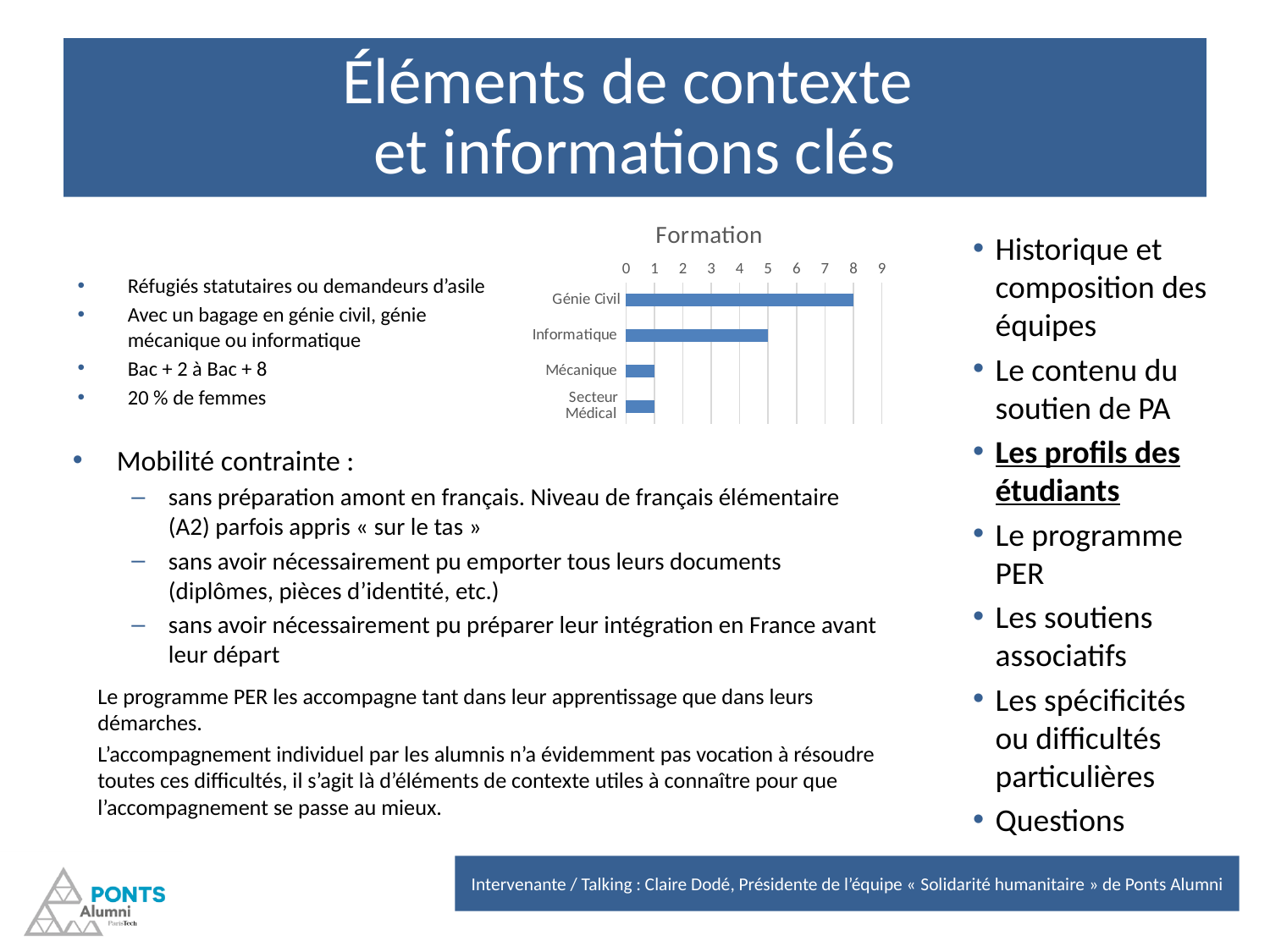
Is the value for Informatique greater or less than 3? greater How many categories are shown in the chart? 4 What is the value for Informatique? 5 What is the value for Génie Civil? 8 What is the difference between the values for Génie Civil and Informatique? 3 Which category has the highest value in the chart? Génie Civil Which is larger, the value for Génie Civil or the value for Informatique? Génie Civil What is the value for Mécanique? 1 Is the value for Secteur Médical greater or less than 3? less What kind of chart is shown on the slide? bar chart What is the title of the chart? Formation What is the difference between the values for Informatique and Mécanique? 4